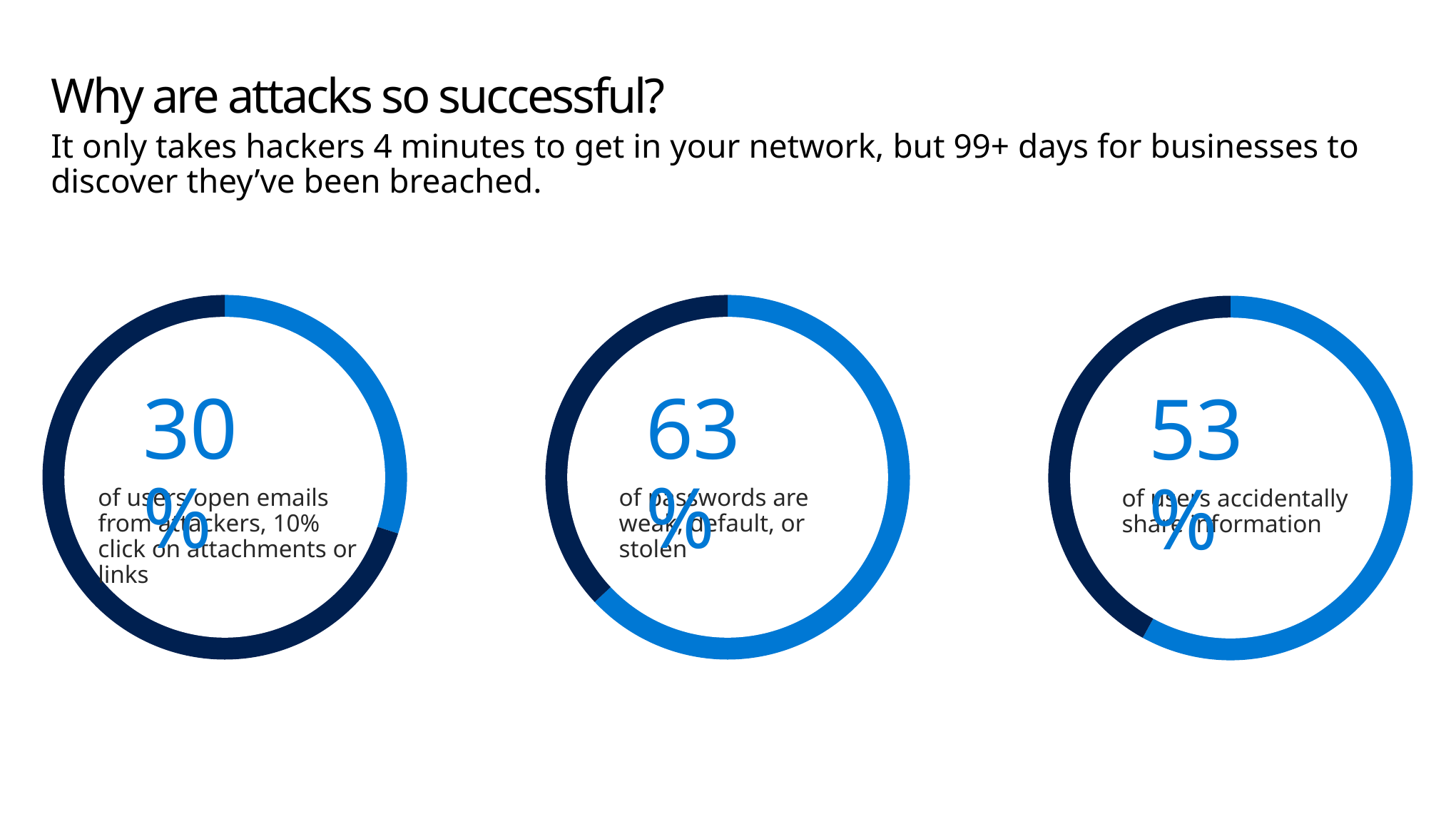
How many donut charts are shown on the slide? 3 Which is larger: the percentage of users who accidentally share information or the percentage of users who open emails from attackers? Users who accidentally share information (53%) What kind of chart is used to display the three statistics on the slide? Donut chart What percentage is shown in the right donut chart about users accidentally sharing information? 53% What is the difference between the percentage in the middle donut chart and the percentage in the left donut chart? 33% What is the title of the slide containing the three donut charts? Why are attacks so successful? Which of the three donut charts shows the highest percentage? The middle chart (passwords weak, default, or stolen), 63% What is the difference between the percentage in the middle donut chart and the percentage in the right donut chart? 10% What percentage is shown in the middle donut chart about passwords being weak, default, or stolen? 63% In the left donut chart, what share of the ring is filled in light blue? 30% Which of the three donut charts shows the lowest percentage? The left chart (users open emails from attackers), 30% What percentage is shown in the left donut chart about users opening emails from attackers? 30%